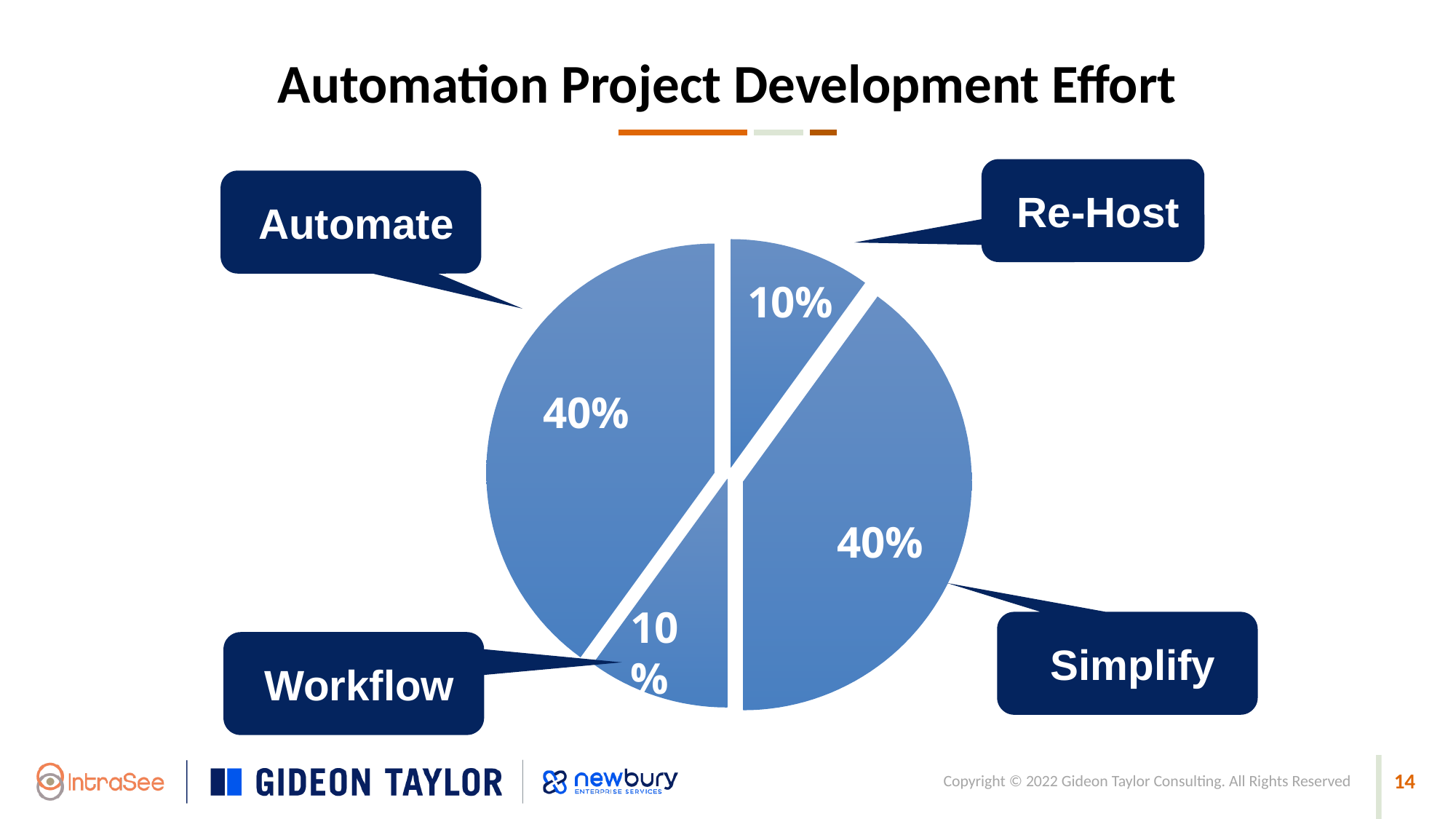
What is the title of the chart? Automation Project Development Effort What kind of chart is shown on the slide? pie chart What is the difference in percentage points between the Simplify slice and the Workflow slice? 30 What share of the pie does the Re-Host slice represent? 10% What share of the pie does the Automate slice represent? 40% How are the slices of the pie chart labelled with their category names? with callout boxes pointing to each slice Which is larger, the Automate slice or the Re-Host slice? Automate Which is larger, the Workflow slice or the Simplify slice? Simplify What share of the pie does the Simplify slice represent? 40% What is the combined share of the Automate and Simplify slices? 80% What share of the pie does the Workflow slice represent? 10% How many slices does the pie chart have? 4